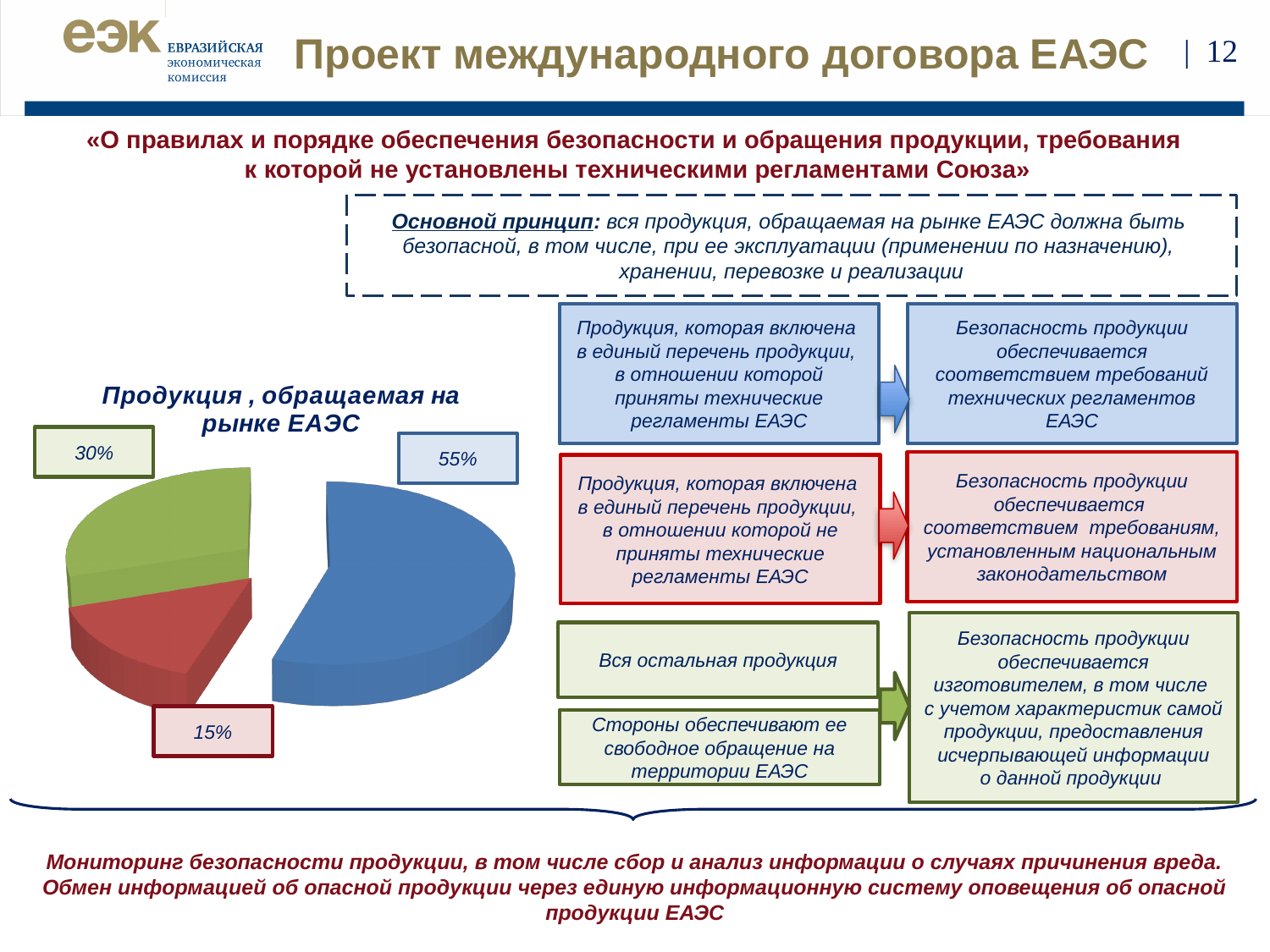
Which is larger in the pie chart, the green slice or the red slice? the green slice Which slice of the pie chart is the largest? the blue slice (55%) What share does the red slice of the pie chart represent? 15% What is the difference between the blue slice and the green slice of the pie chart? 25% What kind of chart is shown on the slide? pie chart What share does the green slice of the pie chart represent? 30% What is the difference between the largest and smallest slices of the pie chart? 40% How many slices does the pie chart have? 3 What share does the blue slice of the pie chart represent? 55% What is the title of the pie chart? Продукция, обращаемая на рынке ЕАЭС Which slice of the pie chart is the smallest? the red slice (15%) What is the total of the three percentages shown on the pie chart? 100%